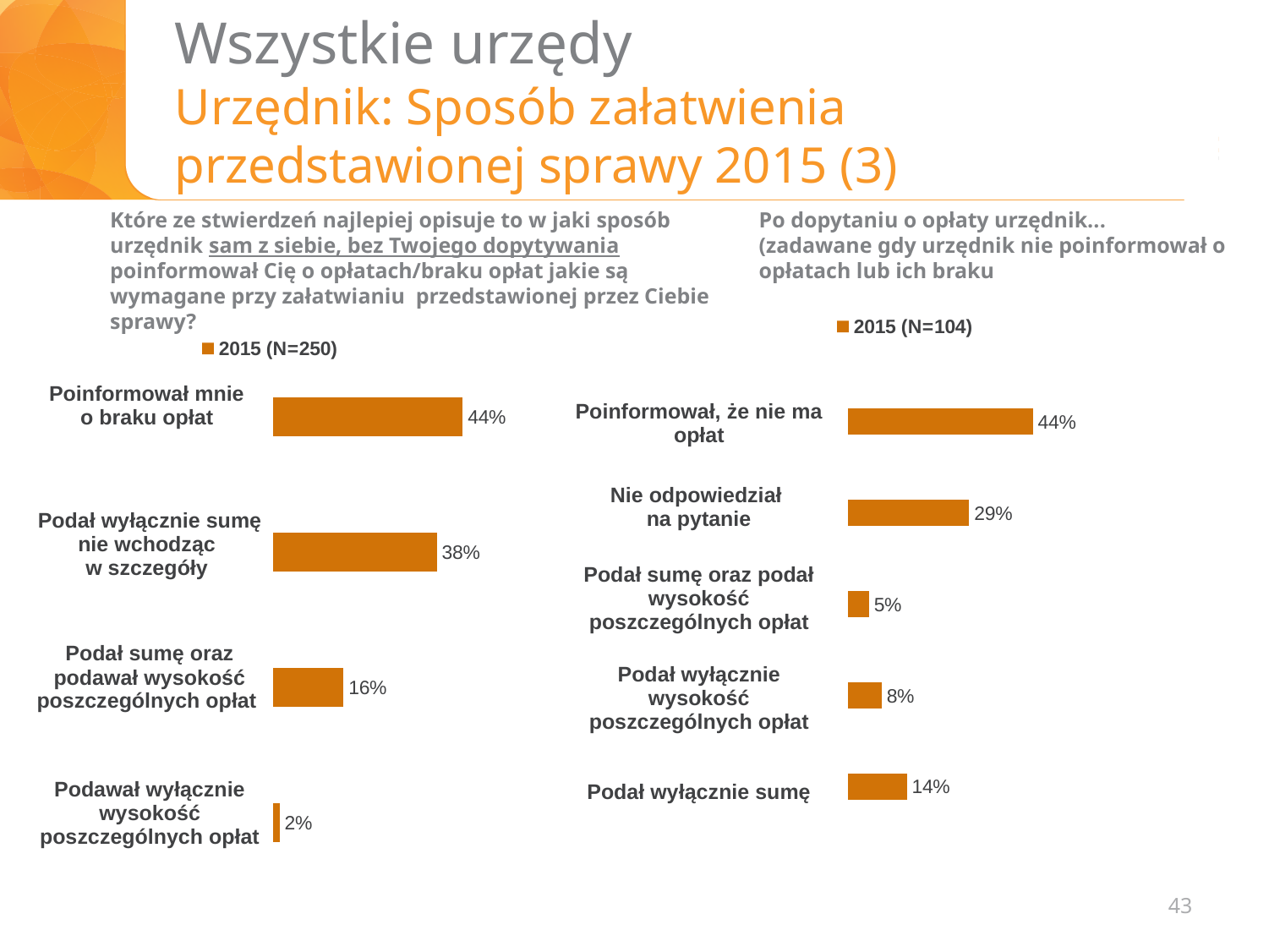
In the right chart (2015, N=104), which is larger: "Podał wyłącznie wysokość poszczególnych opłat" or "Podał wyłącznie sumę"? Podał wyłącznie sumę In the left chart (2015, N=250), how many categories are shown? 4 In the right chart (2015, N=104), which category has the lowest value? Podał sumę oraz podał wysokość poszczególnych opłat In the left chart (2015, N=250), which category has the lowest value? Podawał wyłącznie wysokość poszczególnych opłat In the right chart (2015, N=104), what is the value for "Podał wyłącznie sumę"? 14% In the right chart (2015, N=104), how many categories are shown? 5 In the left chart (2015, N=250), what is the value for "Podał sumę oraz podawał wysokość poszczególnych opłat"? 16% What type of chart is the left chart (2015, N=250)? Bar chart In the left chart (2015, N=250), what is the value for "Poinformował mnie o braku opłat"? 44% In the left chart (2015, N=250), what is the difference between "Poinformował mnie o braku opłat" and "Podał wyłącznie sumę nie wchodząc w szczegóły"? 6 percentage points In the right chart (2015, N=104), what is the value for "Nie odpowiedział na pytanie"? 29% In the right chart (2015, N=104), which category has the highest value? Poinformował, że nie ma opłat